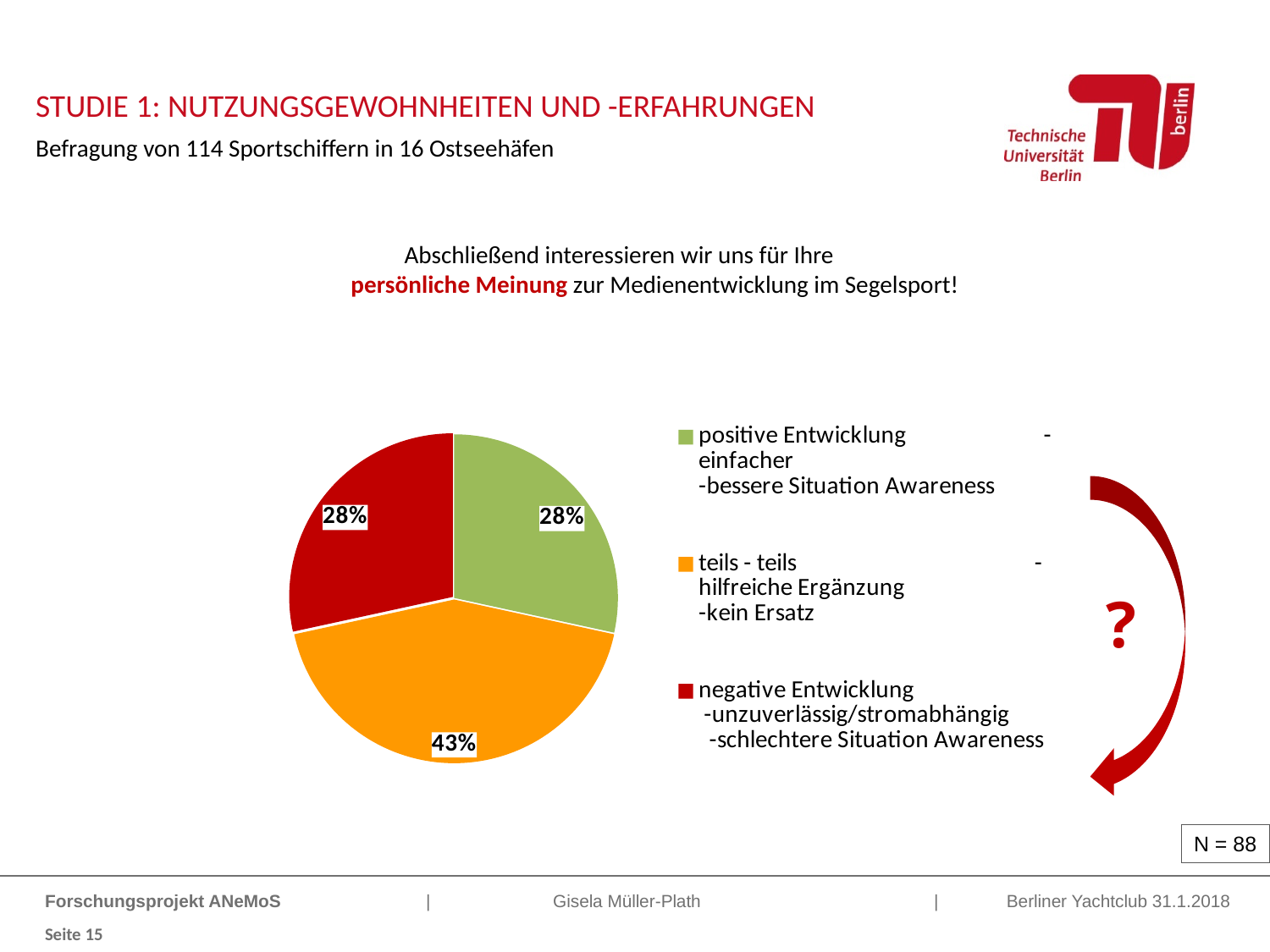
What sample size (N) is given for the pie chart? N = 88 How many entries does the legend list? 3 What share of the pie does "teils - teils" take? 43% What colour is the slice for "negative Entwicklung"? red What share of the pie does "positive Entwicklung" take? 28% Which category has the largest slice of the pie? teils - teils What share of the pie does "negative Entwicklung" take? 28% Is the share for "teils - teils" greater or less than 40%? greater Which is larger, the slice for "teils - teils" or the slice for "positive Entwicklung"? teils - teils What is the difference in percentage points between the "teils - teils" slice and the "negative Entwicklung" slice? 15% What kind of chart is shown on the slide? pie chart How many slices does the pie chart have? 3